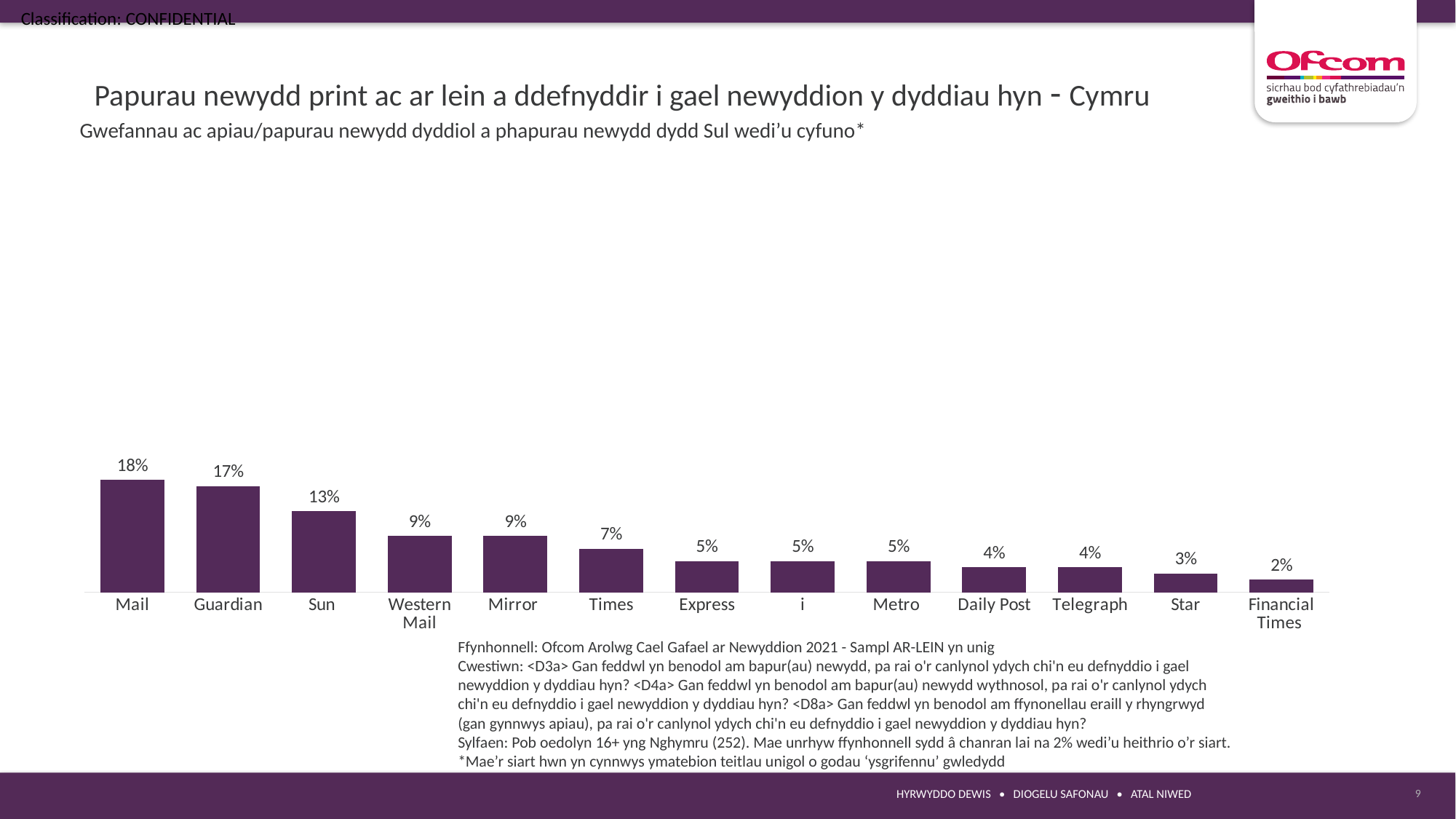
Which is larger, the value for Times or the value for Telegraph? Times What is the difference between the values for Mail and Financial Times? 16% What is the value for Mail? 18% What is the value for Star? 3% What is the value for Western Mail? 9% Which newspaper has the lowest value? Financial Times What kind of chart is shown on the slide? Bar chart What is the value for Daily Post? 4% Which newspaper has the highest value? Mail Do the values rise or fall from left to right across the chart? Fall What is the difference between the values for Guardian and Sun? 4% How many newspapers are shown in the chart? 13